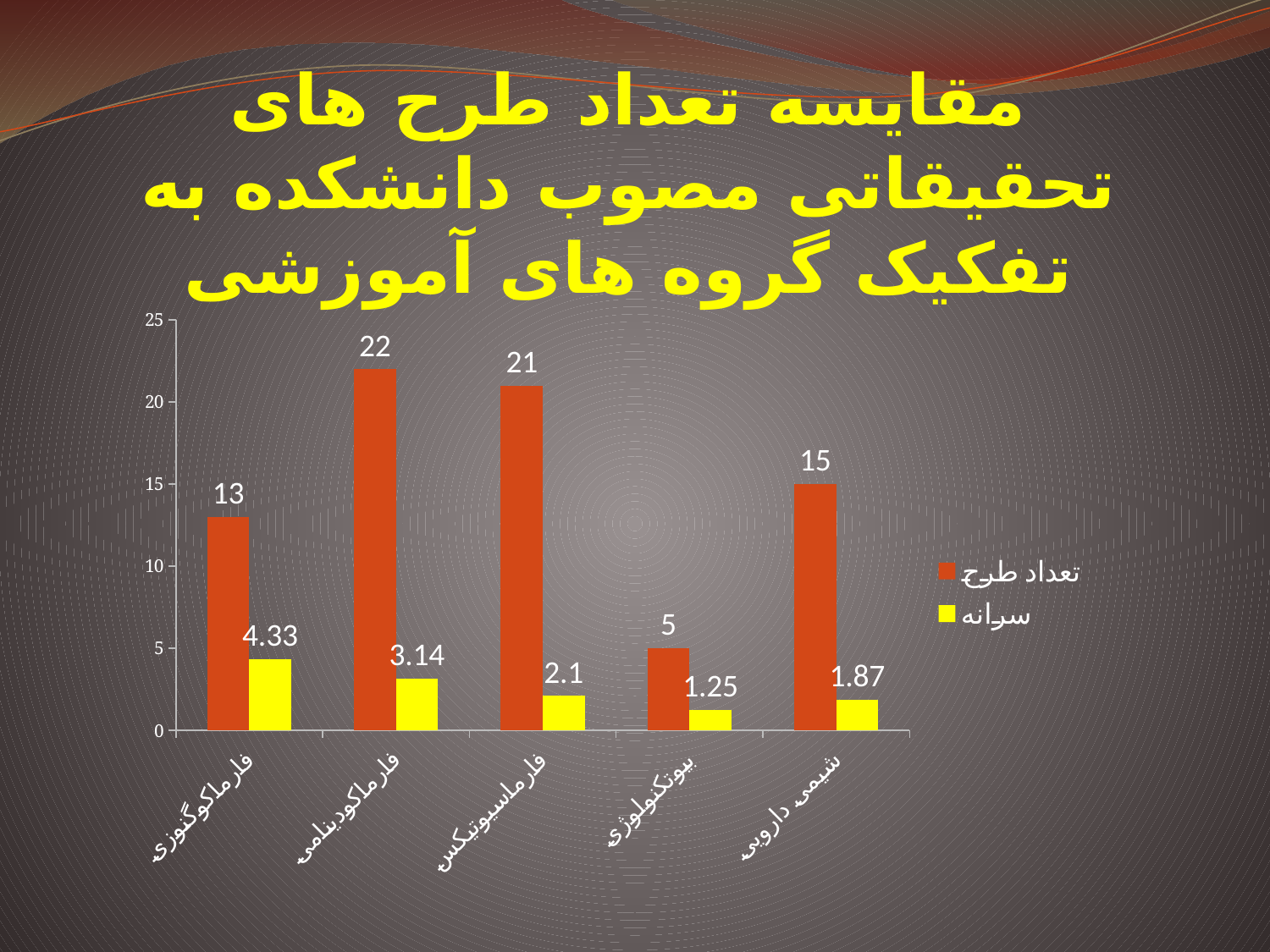
What is the value of تعداد طرح for بیوتکنولوژی? 5 How many series does the legend list? 2 What is the value of سرانه for فارماکوگنوزی? 4.33 Which category has the highest value of تعداد طرح? فارماکودینامی Which is larger: the سرانه value for فارماسیوتیکس or for شیمی دارویی? فارماسیوتیکس What is the difference between the تعداد طرح values for فارماکودینامی and شیمی دارویی? 7 Which category has the lowest value of سرانه? بیوتکنولوژی Which series is shown in yellow in the legend? سرانه How many categories (educational groups) are shown on the x axis? 5 What type of chart is shown on the slide? Bar chart What is the value of سرانه for شیمی دارویی? 1.87 What is the value of تعداد طرح for فارماکودینامی? 22